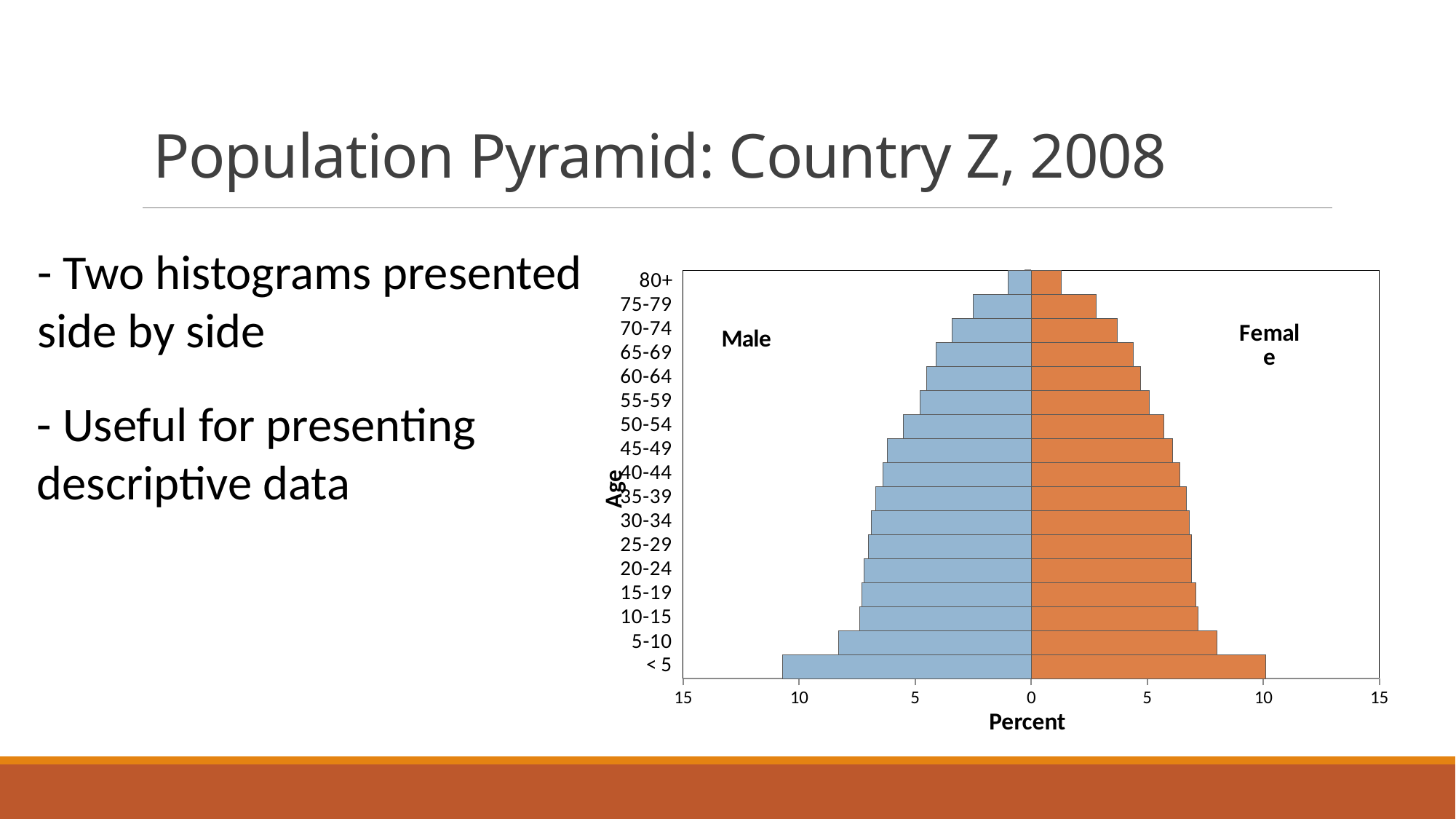
How many age groups are listed on the vertical axis of the population pyramid? 17 Which age group has the longest bars in the population pyramid? < 5 Which is larger, the Male bar for the < 5 age group or the Male bar for the 5-10 age group? < 5 Do the bar lengths generally increase or decrease moving from the 80+ age group down to the < 5 age group? increase What kind of chart is shown on the slide? bar chart Is the Male value for the 30-34 age group greater or less than 5? greater Is the Male value for the 80+ age group greater or less than 5? less Is the Male value for the < 5 age group greater or less than 10? greater What is the title of the horizontal axis of the population pyramid? Percent Which age group has the shortest bars in the population pyramid? 80+